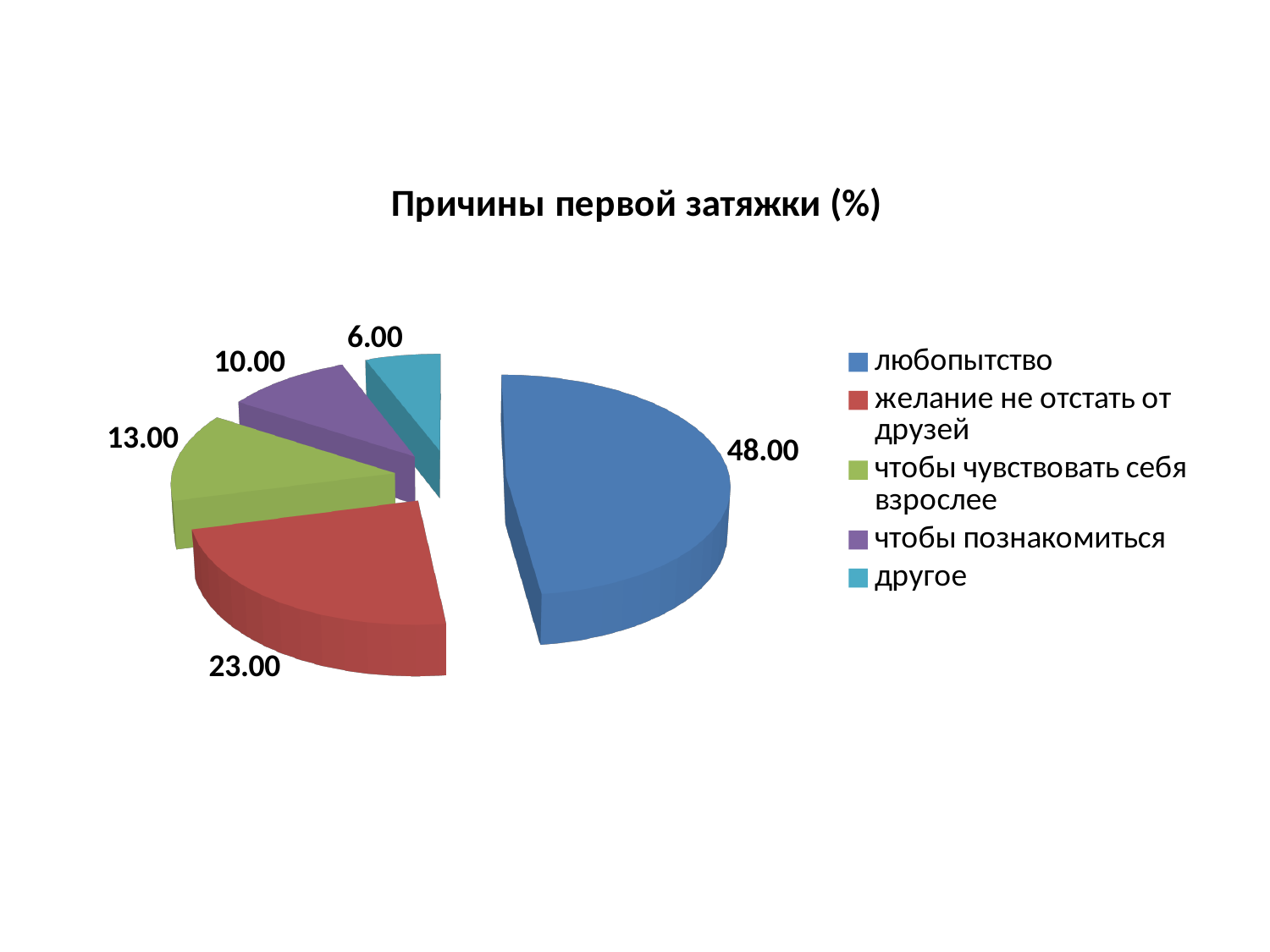
What is the difference between the values for любопытство and желание не отстать от друзей? 25.00 What is the value for чтобы чувствовать себя взрослее? 13.00 What is the value for желание не отстать от друзей? 23.00 Which is larger, the value for чтобы чувствовать себя взрослее or the value for чтобы познакомиться? чтобы чувствовать себя взрослее What is the value for другое? 6.00 What is the title of the chart? Причины первой затяжки (%) What type of chart is shown on the slide? pie chart How many categories does the legend list? 5 Which category has the smallest slice? другое What is the value for любопытство? 48.00 Which category has the largest slice? любопытство What is the value for чтобы познакомиться? 10.00